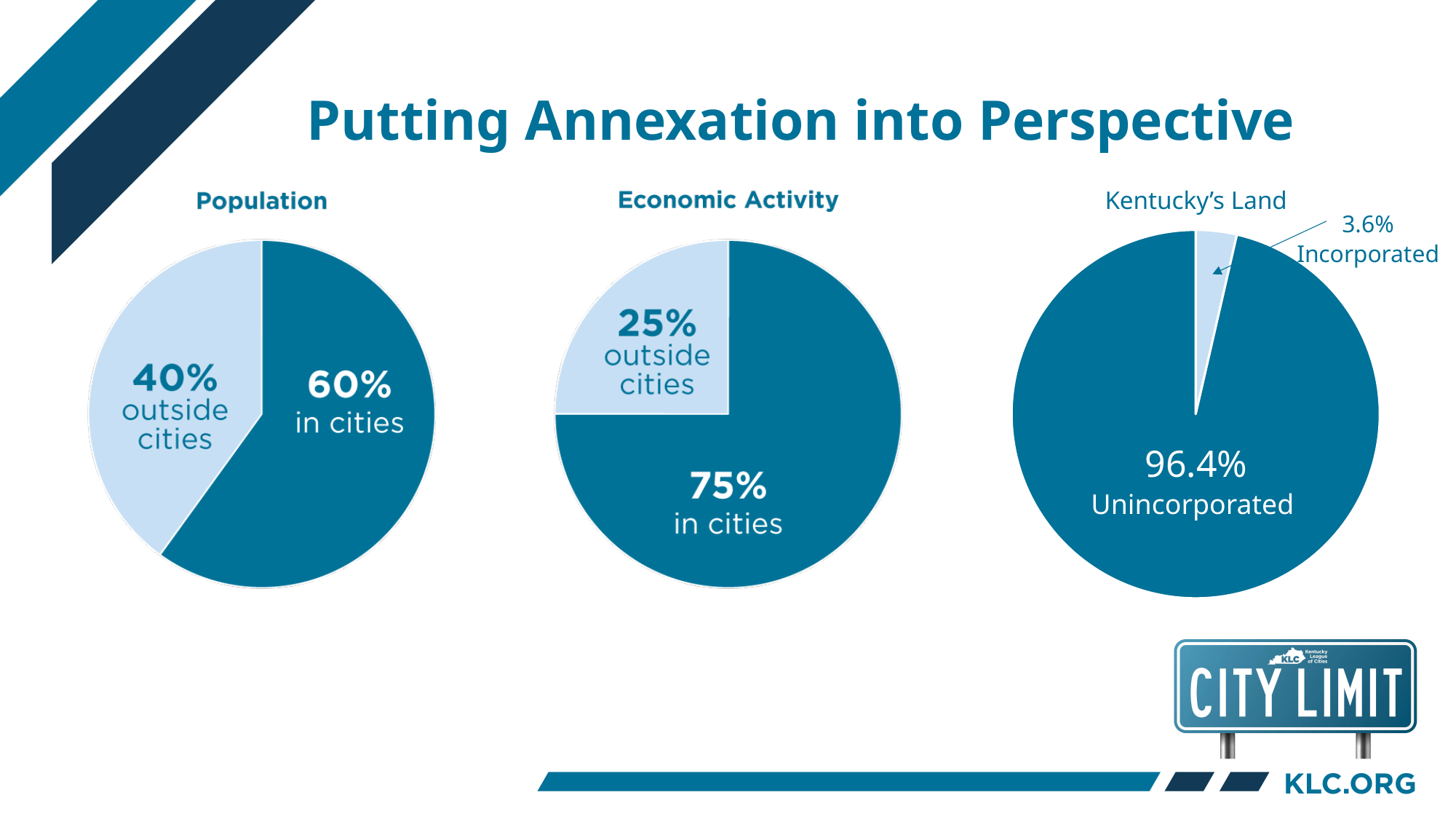
In the Kentucky's Land chart, what share of land is Unincorporated? 96.4% In the Population chart, what share of the population is outside cities? 40% In the Economic Activity chart, what share of economic activity is in cities? 75% In the Population chart, which slice is larger: in cities or outside cities? in cities What kind of chart is the Population chart? pie chart How many pie charts are shown on the slide? 3 How many slices does the Economic Activity chart have? 2 In the Economic Activity chart, what is the difference between the in cities share and the outside cities share? 50% In the Kentucky's Land chart, which slice is the smallest? Incorporated